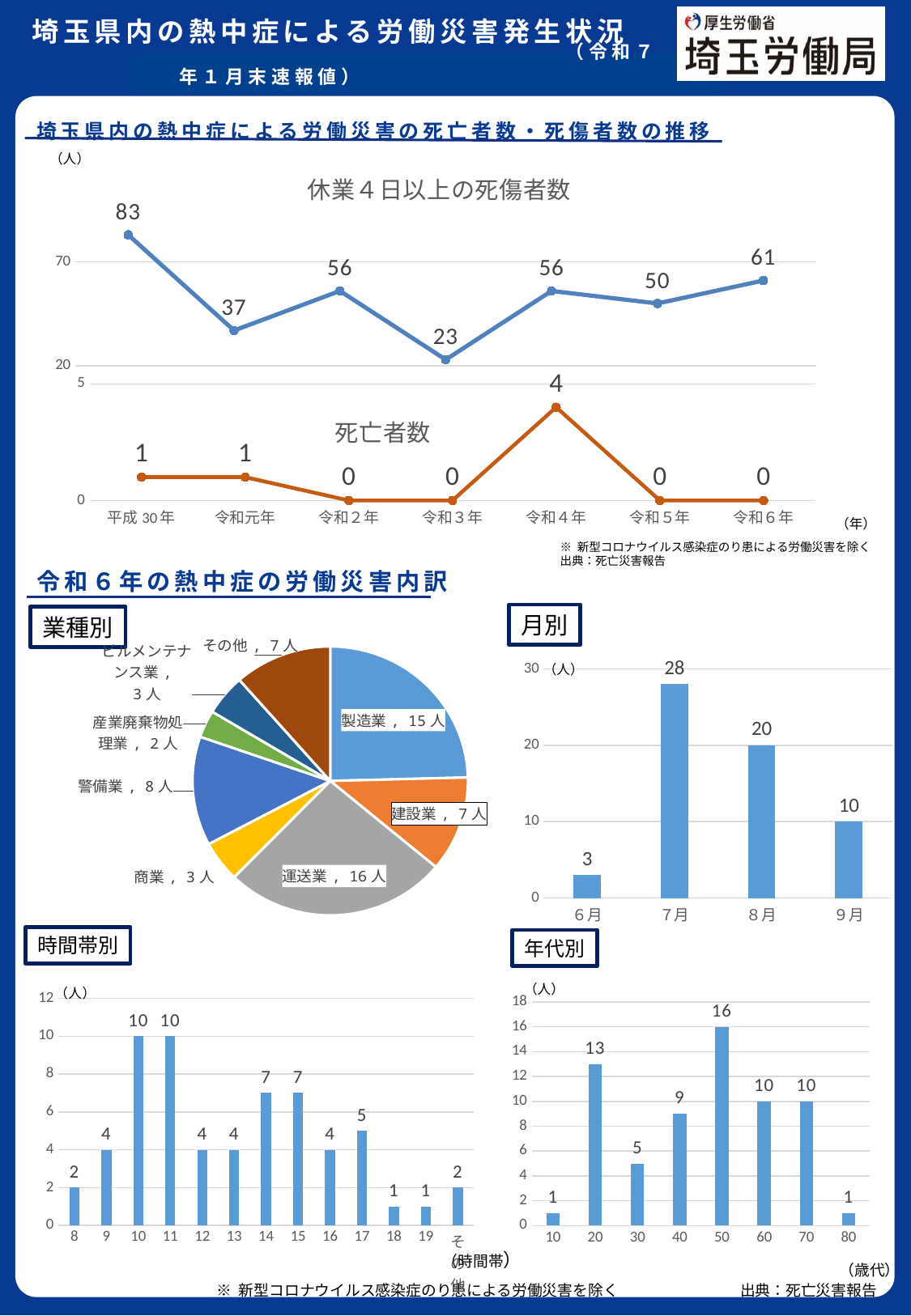
In the bar chart 年代別, which age group has the highest value? 50 In the line chart 埼玉県内の熱中症による労働災害の死亡者数・死傷者数の推移, what is the 死亡者数 for 令和４年? 4 In the line chart 埼玉県内の熱中症による労働災害の死亡者数・死傷者数の推移, what is the difference in 休業４日以上の死傷者数 between 平成30年 and 令和３年? 60 In the bar chart 月別, what is the difference between 7月 and 9月? 18 In the line chart 埼玉県内の熱中症による労働災害の死亡者数・死傷者数の推移, what is the value of 休業４日以上の死傷者数 for 令和６年? 61 In the bar chart 年代別, which is larger, the value for 20 or the value for 40? 20 In the pie chart 業種別, how many categories (slices) are shown? 8 In the pie chart 業種別, which industry has the smallest number of people? 産業廃棄物処理業 In the bar chart 月別, which month has the highest value? 7月 In the line chart 埼玉県内の熱中症による労働災害の死亡者数・死傷者数の推移, which year has the highest 休業４日以上の死傷者数? 平成30年 In the bar chart 時間帯別, what is the value for 17? 5 In the pie chart 業種別, how many people are in 運送業? 16人